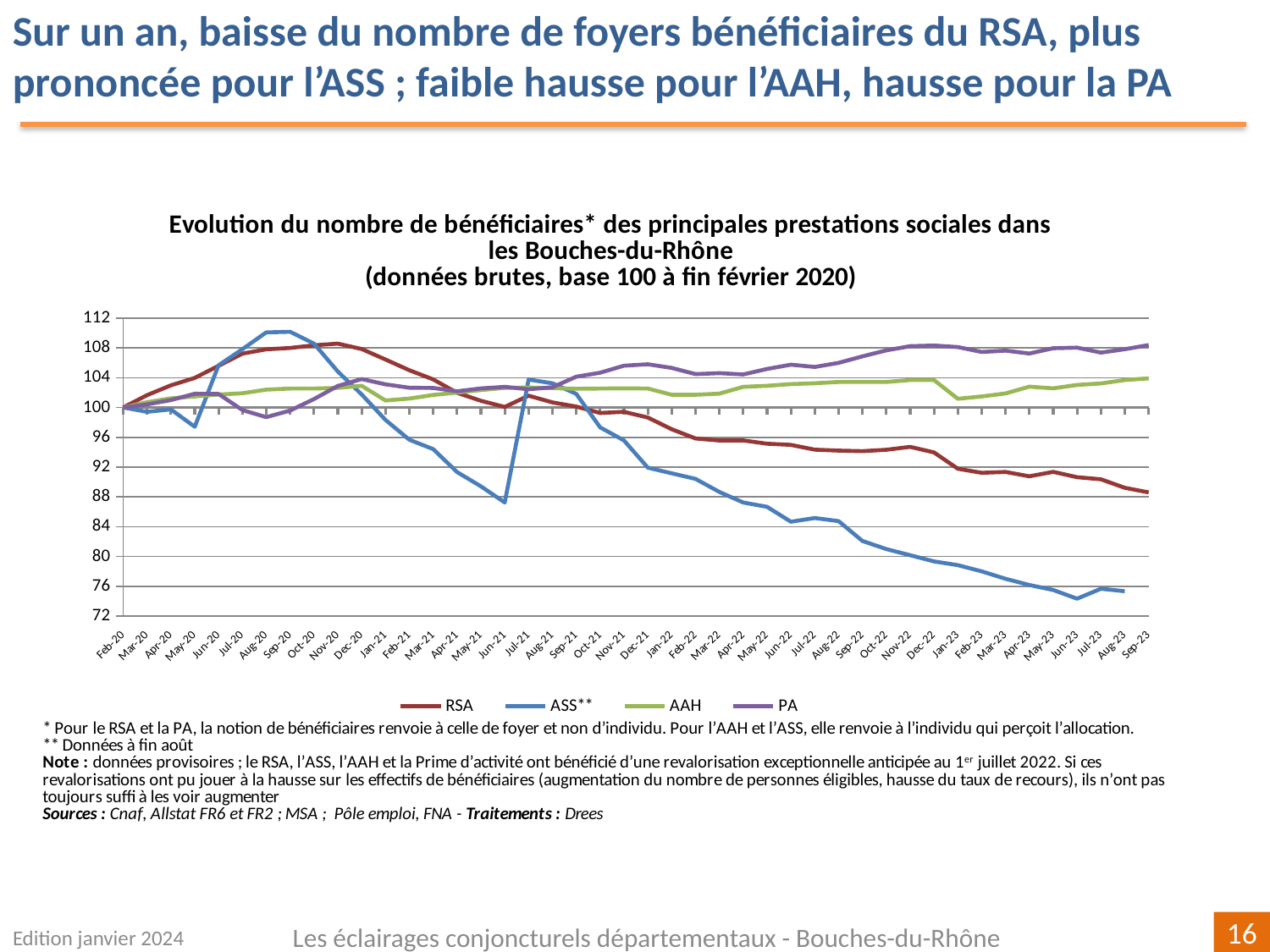
What is the value of every series at Feb-20, the base month? 100 Does the ASS** series rise or fall between Jul-21 and Sep-23? fall Is the value for RSA at Sep-23 greater or less than 92? less Which series has the lowest value at Sep-23? RSA How many series does the legend list? 4 What kind of chart is shown on the slide? line chart Which series has the highest value at Sep-23? PA Is the value for PA at Sep-23 greater or less than 104? greater At Sep-23, which is larger, the value for AAH or the value for RSA? AAH Which series are listed in the legend? RSA, ASS**, AAH, PA Is the value for ASS** at Sep-20 greater or less than 108? greater